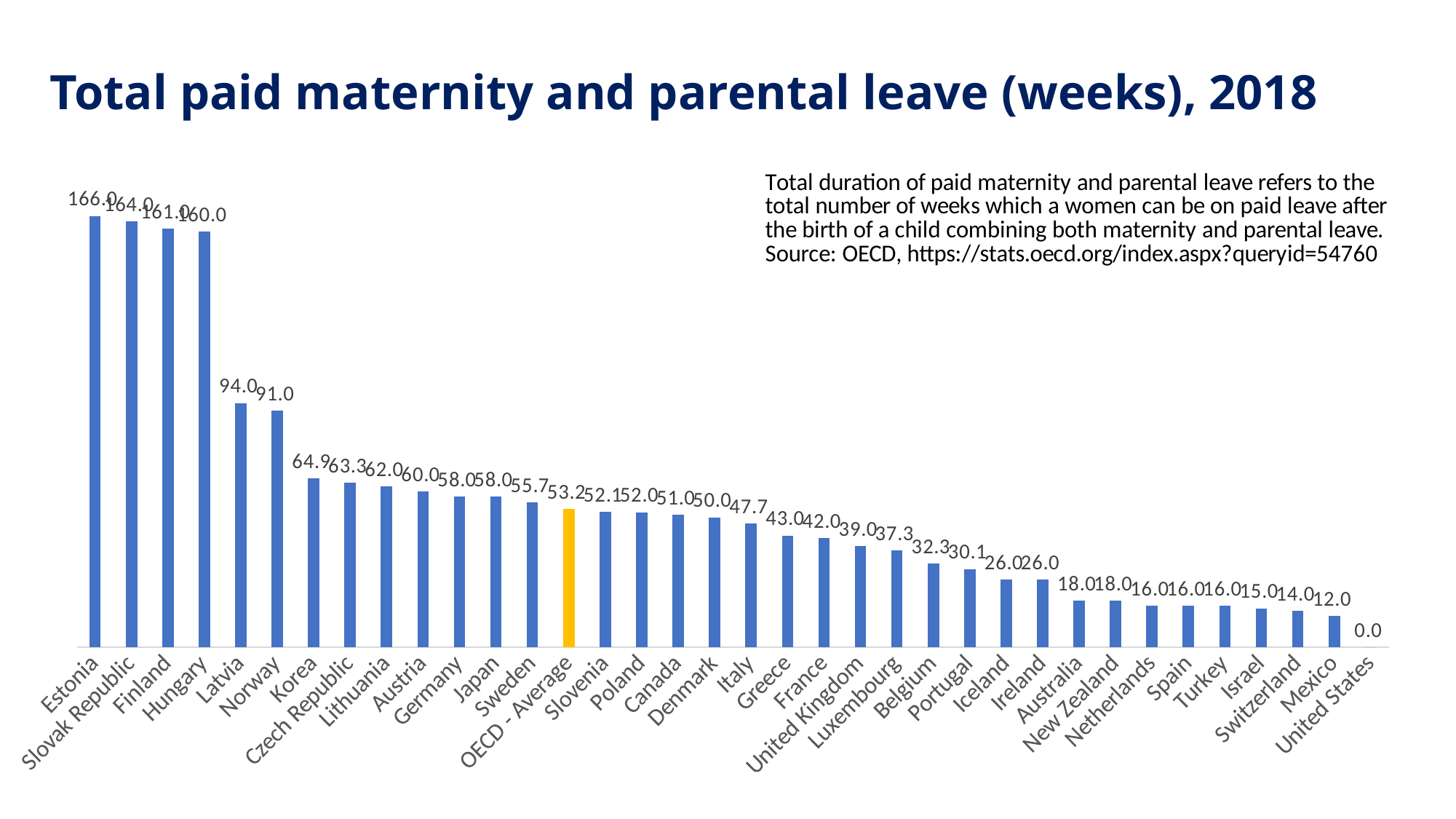
Which bar is shown in a different colour (orange) from the others? OECD - Average What is the difference between the values for Latvia and Norway? 3.0 What is the value for Mexico? 12.0 How many categories are shown on the x axis? 36 What kind of chart is shown on the slide? Bar chart What is the value for OECD - Average? 53.2 Which has a larger value, Korea or Czech Republic? Korea What is the value for Latvia? 94.0 What is the value for Italy? 47.7 What is the difference between the values for Estonia and Mexico? 154.0 Which country has the highest value? Estonia Which country has the lowest value? United States